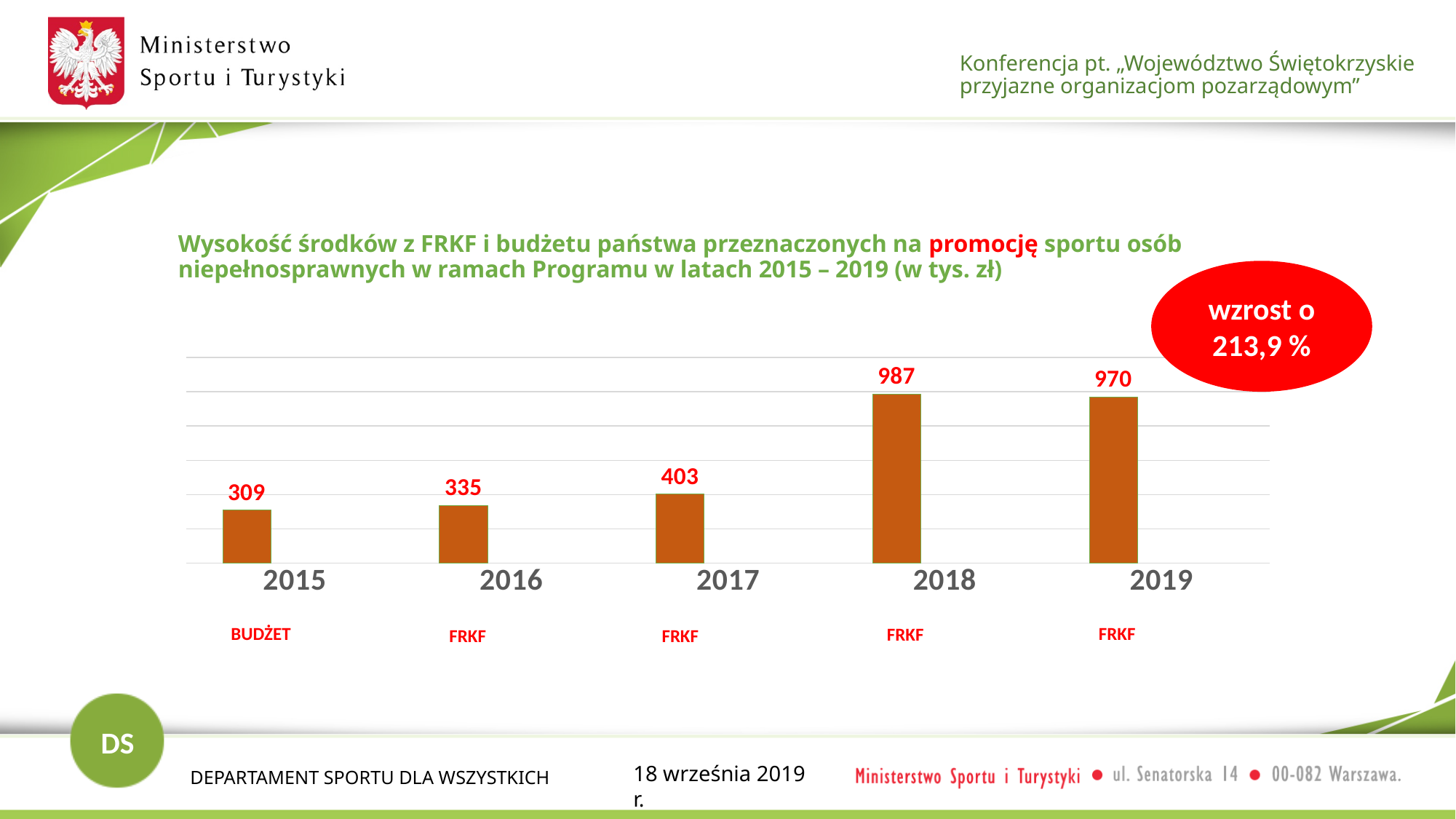
What is the value for 2015? 309 How many years are shown on the x axis? 5 What is the difference between the values for 2018 and 2017? 584 What is the value for 2019? 970 What percentage increase is stated in the red oval on the slide? 213,9 % Which year has the lowest value? 2015 Which is larger, the value for 2018 or the value for 2019? 2018 What kind of chart is shown? bar chart Which year has the highest value? 2018 Do the values rise or fall from 2015 to 2018? rise What is the value for 2017? 403 What is the difference between the values for 2016 and 2015? 26